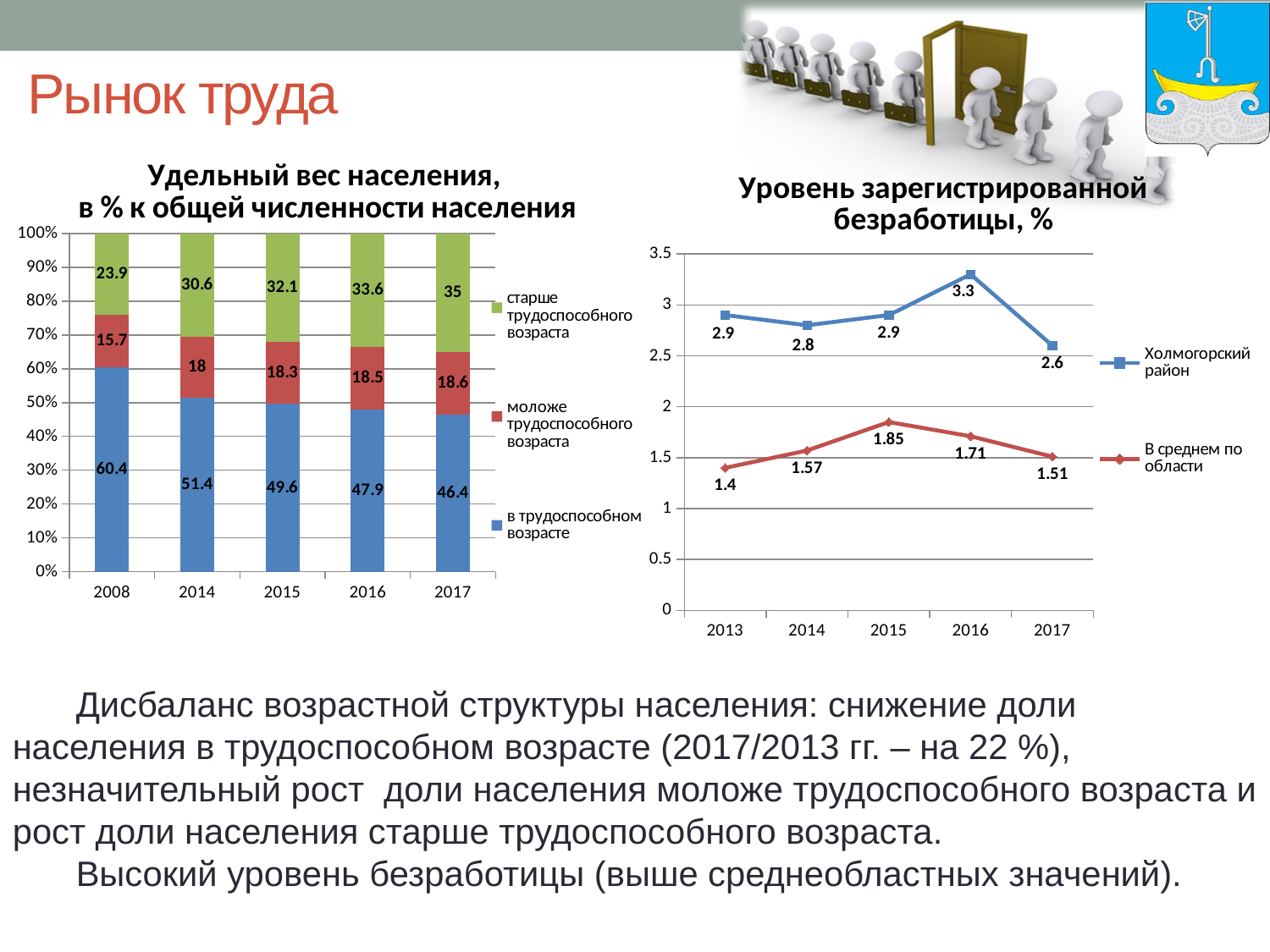
In the chart 'Уровень зарегистрированной безработицы, %', how many years are shown on the x axis? 5 In the chart 'Уровень зарегистрированной безработицы, %', what is the difference between 'Холмогорский район' and 'В среднем по области' in 2017? 1.09 In the chart 'Удельный вес населения, в % к общей численности населения', does the value for 'старше трудоспособного возраста' rise or fall from 2008 to 2017? rise In the chart 'Уровень зарегистрированной безработицы, %', what is the value for 'Холмогорский район' in 2016? 3.3 In the chart 'Уровень зарегистрированной безработицы, %', what is the value for 'В среднем по области' in 2013? 1.4 In the chart 'Уровень зарегистрированной безработицы, %', which year has the highest value for 'В среднем по области'? 2015 In the chart 'Удельный вес населения, в % к общей численности населения', how many series does the legend list? 3 What kind of chart is 'Удельный вес населения, в % к общей численности населения'? stacked bar chart In the chart 'Удельный вес населения, в % к общей численности населения', what is the value for 'старше трудоспособного возраста' in 2017? 35 In the chart 'Удельный вес населения, в % к общей численности населения', which year has the lowest value for 'в трудоспособном возрасте'? 2017 In the chart 'Удельный вес населения, в % к общей численности населения', what is the value for 'в трудоспособном возрасте' in 2008? 60.4 In the chart 'Удельный вес населения, в % к общей численности населения', what is the difference between the 'моложе трудоспособного возраста' values for 2017 and 2008? 2.9